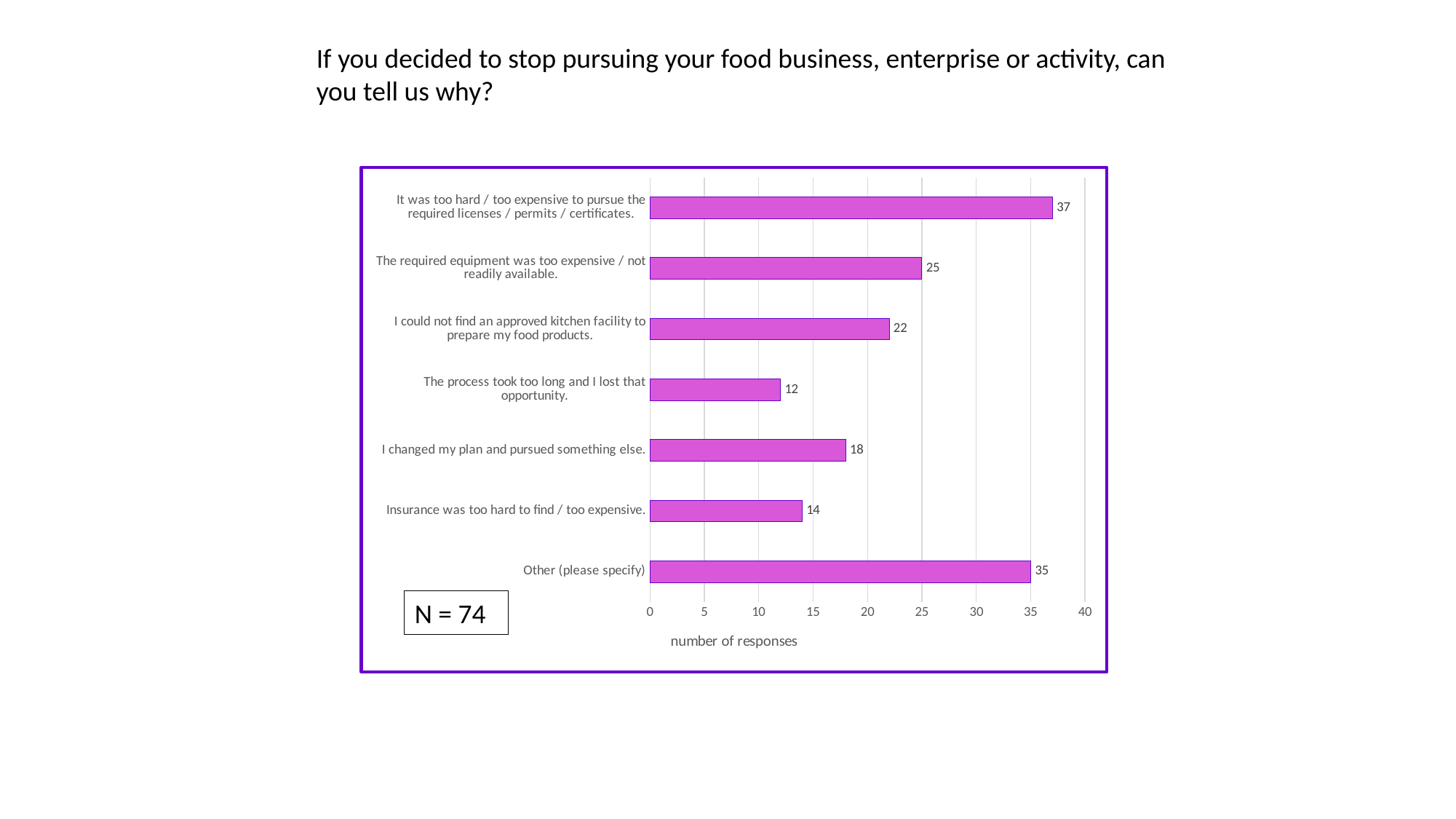
What is the label on the horizontal axis of the chart? number of responses How many reason categories are shown in the chart? 7 How many responses does "Other (please specify)" have? 35 Is the value for "The process took too long and I lost that opportunity." greater or less than 15? less What is the difference in responses between "The required equipment was too expensive / not readily available." and "I could not find an approved kitchen facility to prepare my food products."? 3 What is the number of responses for "Insurance was too hard to find / too expensive."? 14 What kind of chart is shown on the slide? bar chart How many responses were given for "It was too hard / too expensive to pursue the required licenses / permits / certificates."? 37 Which has more responses: "I changed my plan and pursued something else." or "Insurance was too hard to find / too expensive."? I changed my plan and pursued something else. Which reason received the fewest responses? The process took too long and I lost that opportunity. What sample size (N) is shown on the slide? N = 74 Which reason received the most responses? It was too hard / too expensive to pursue the required licenses / permits / certificates.